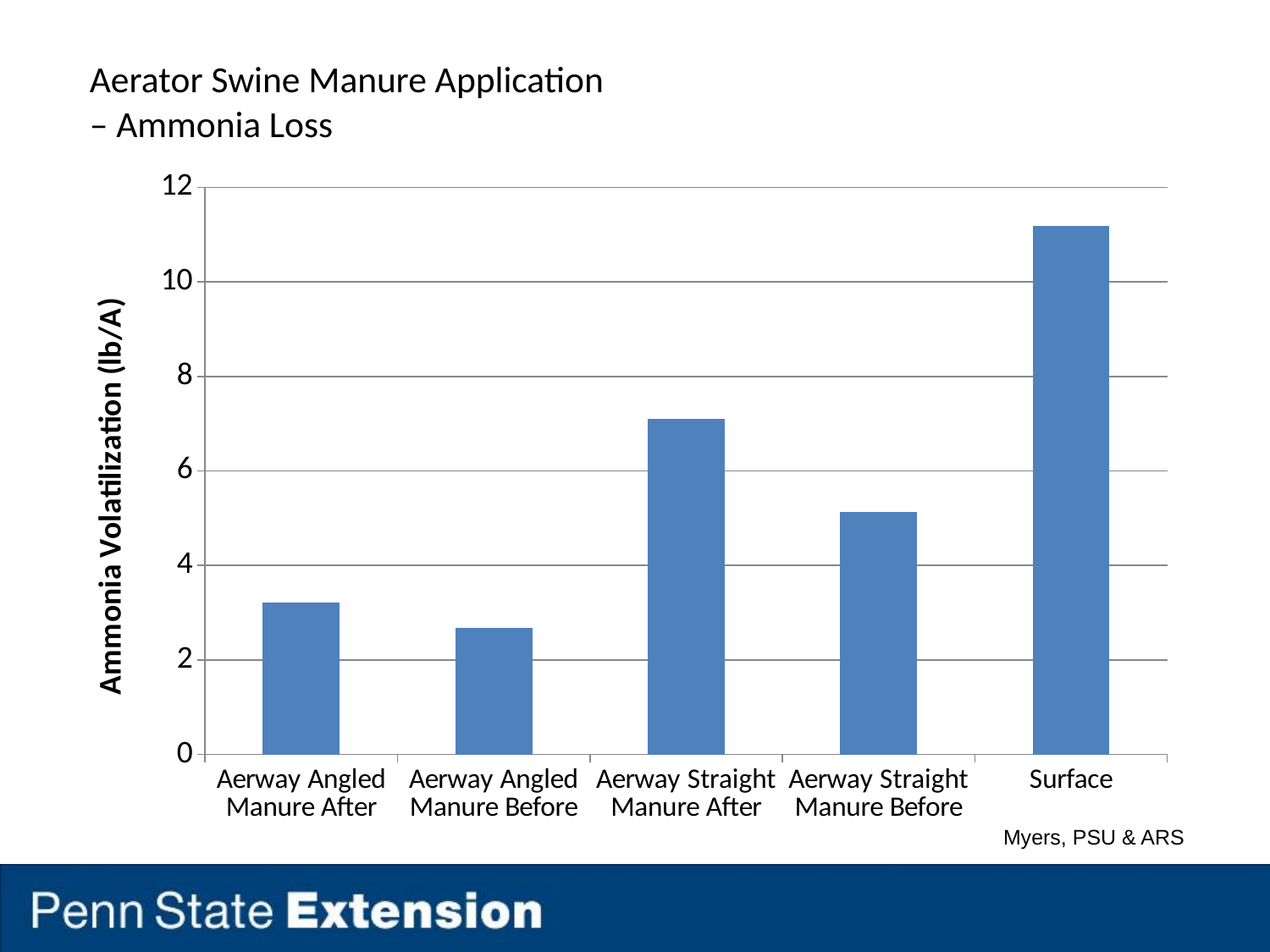
Which category has the lowest ammonia volatilization? Aerway Angled Manure Before Is the value for Aerway Straight Manure Before greater or less than 6? less Is the value for Aerway Straight Manure After greater or less than 6? greater Is the value for Aerway Angled Manure Before greater or less than 4? less Which is larger, the value for Aerway Straight Manure After or Aerway Straight Manure Before? Aerway Straight Manure After What is the label of the y axis? Ammonia Volatilization (lb/A) Which is larger, the value for Aerway Angled Manure After or Aerway Straight Manure Before? Aerway Straight Manure Before What kind of chart is shown on the slide? Bar chart How many categories are shown on the x axis? 5 Which category has the highest ammonia volatilization? Surface What is the maximum value shown on the y axis? 12